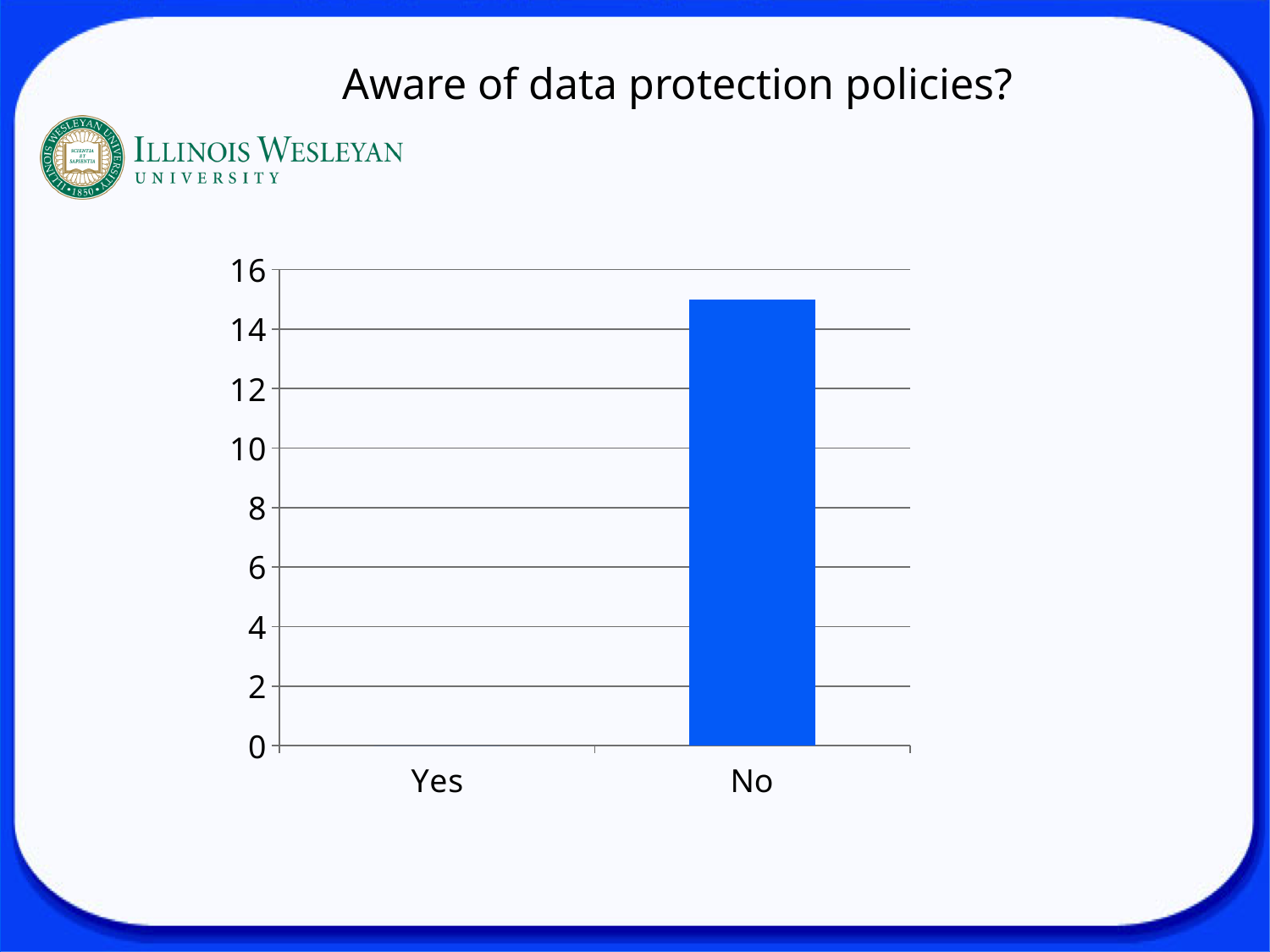
Do the values rise or fall going from Yes to No along the x axis? rise What is the title of the chart? Aware of data protection policies? Is the value for No greater or less than 14? greater Is the value for No greater or less than 16? less What kind of chart is shown on the slide? bar chart What is the value for Yes in the chart? 0 Which is larger, the value for Yes or the value for No? No How many categories are shown on the x axis of the chart? 2 What colour is the bar in the chart? blue Which category has the highest value in the chart? No Which category has the lowest value in the chart? Yes Is the value for No greater or less than 10? greater